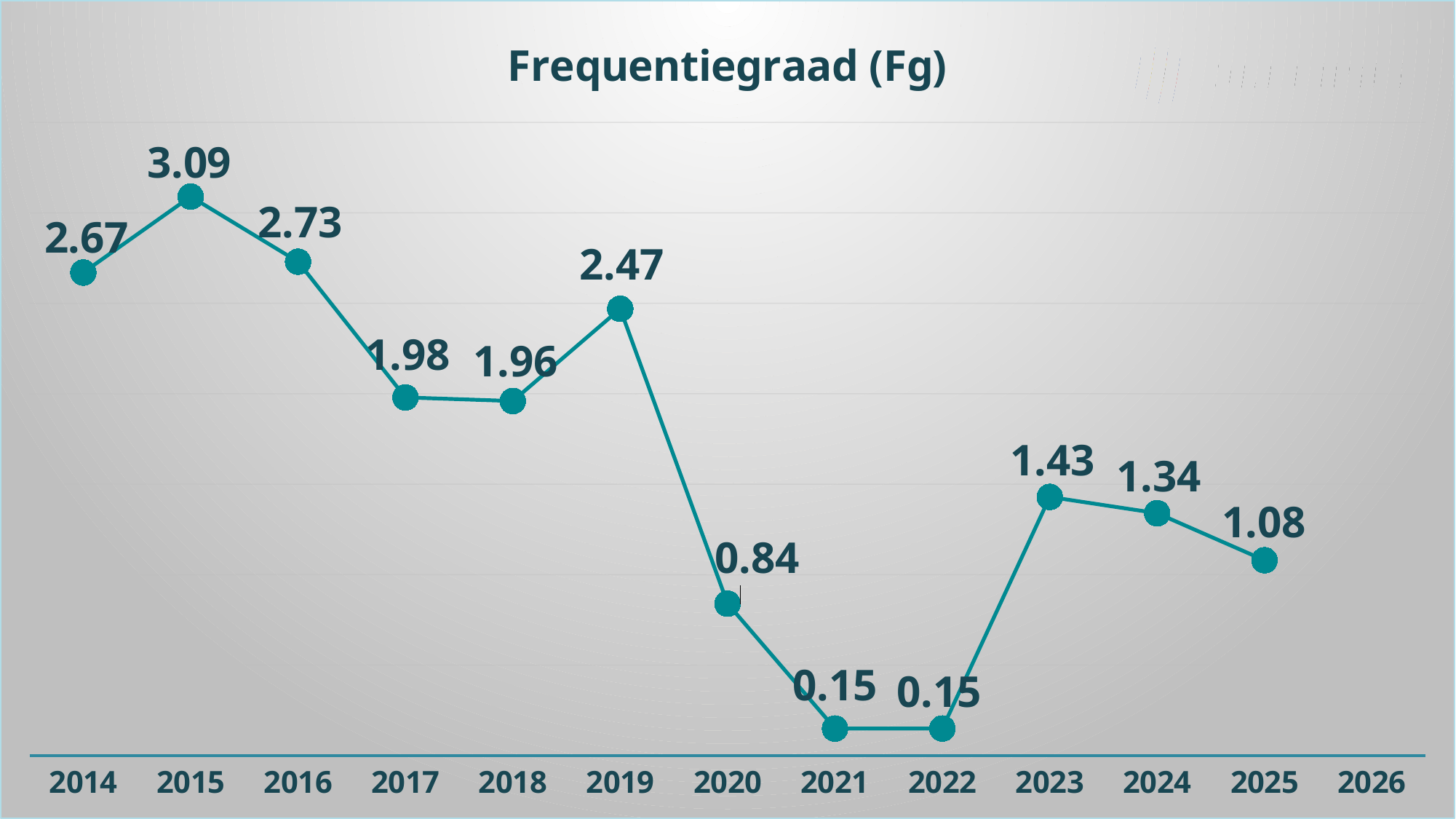
Overall, do the values rise or fall from 2014 to 2025? fall What type of chart is shown on the slide? line chart Which two years share the lowest value? 2021 and 2022 What is the difference between the values for 2019 and 2020? 1.63 How many data points are plotted on the line? 12 What is the value for 2020? 0.84 What is the title of the chart? Frequentiegraad (Fg) What is the difference between the values for 2015 and 2014? 0.42 What is the value for 2025? 1.08 Which is larger, the value for 2023 or the value for 2024? 2023 What is the value for 2015? 3.09 Which year has the highest value? 2015